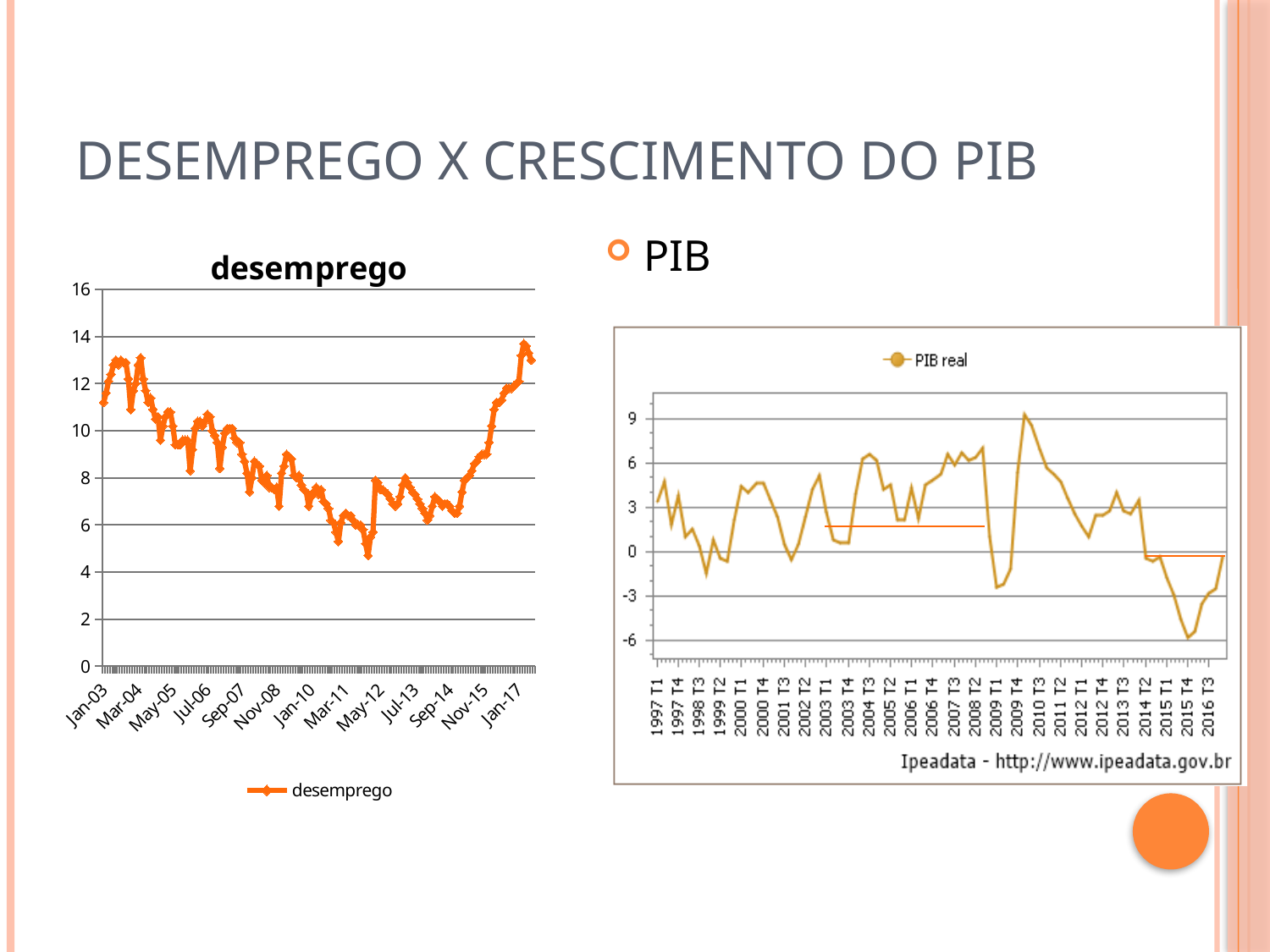
In the 'desemprego' chart, is the lowest value of the series greater or less than 6? less What kind of chart is the 'PIB real' chart on the right of the slide? line chart In the 'desemprego' chart, do the values rise or fall between Sep-14 and Jan-17? rise In the 'desemprego' chart, do the values rise or fall between Jan-03 and Mar-11? fall What is the title of the chart on the left of the slide? desemprego What is the legend entry shown on the chart on the right of the slide? PIB real What kind of chart is the 'desemprego' chart on the left of the slide? line chart In the 'PIB real' chart, is the highest value of the series greater or less than 6? greater In the 'desemprego' chart, is the value at Jan-03 greater or less than 10? greater How many series does the legend of the 'desemprego' chart list? 1